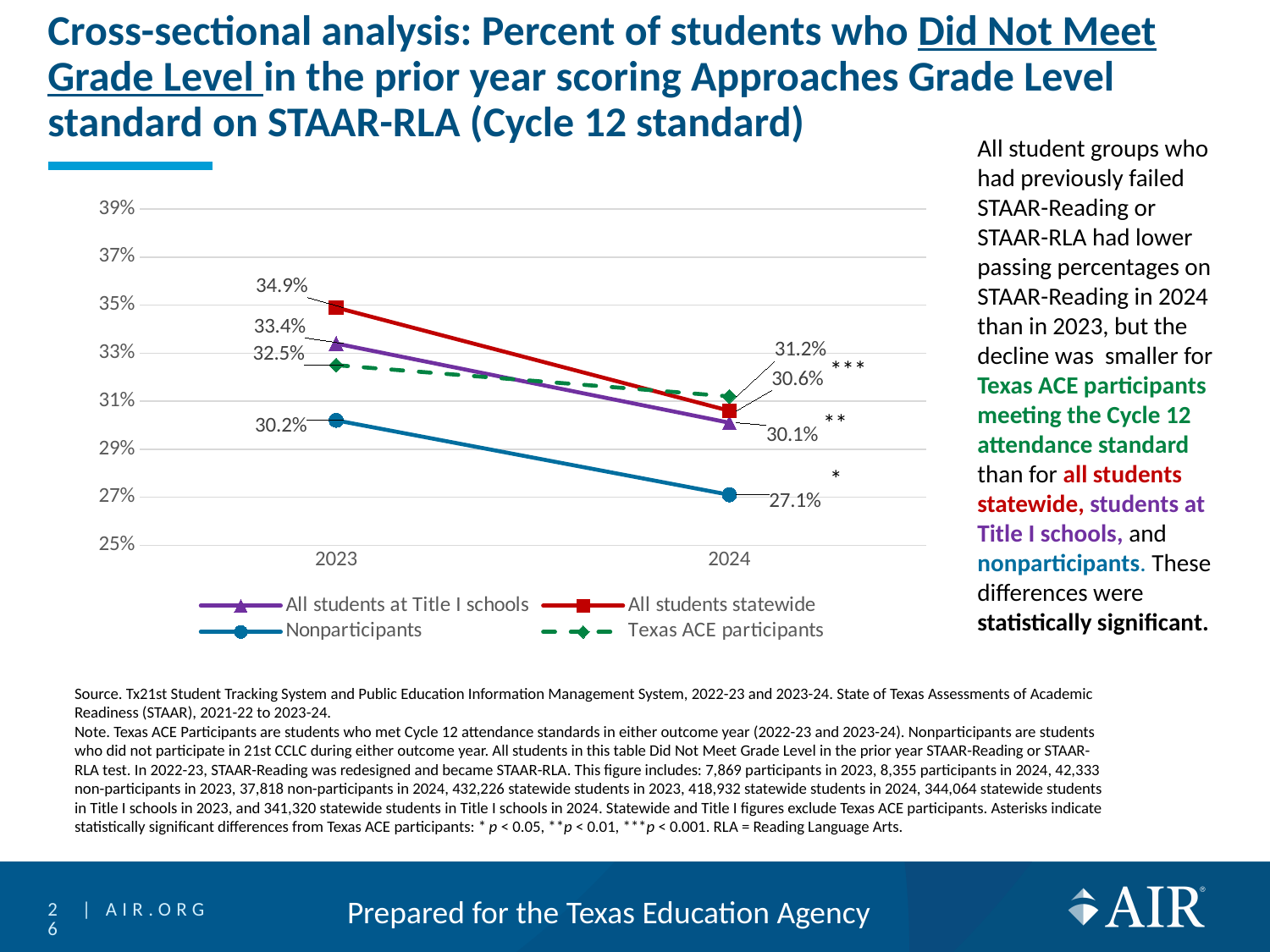
What type of chart is shown on the slide? Line chart Which series had the highest value in 2023? All students statewide By how many percentage points did the value for Texas ACE participants fall from 2023 to 2024? 1.3 percentage points What was the value for All students at Title I schools in 2024? 30.1% Which series had the lowest value in 2024? Nonparticipants Do the values for Nonparticipants rise or fall from 2023 to 2024? Fall In 2024, which was larger: the value for Texas ACE participants or the value for All students statewide? Texas ACE participants What was the value for All students statewide in 2023? 34.9% How many series does the legend list? 4 By how many percentage points did the value for All students statewide fall from 2023 to 2024? 4.3 percentage points What was the value for Nonparticipants in 2023? 30.2% What was the value for Texas ACE participants in 2024? 31.2%